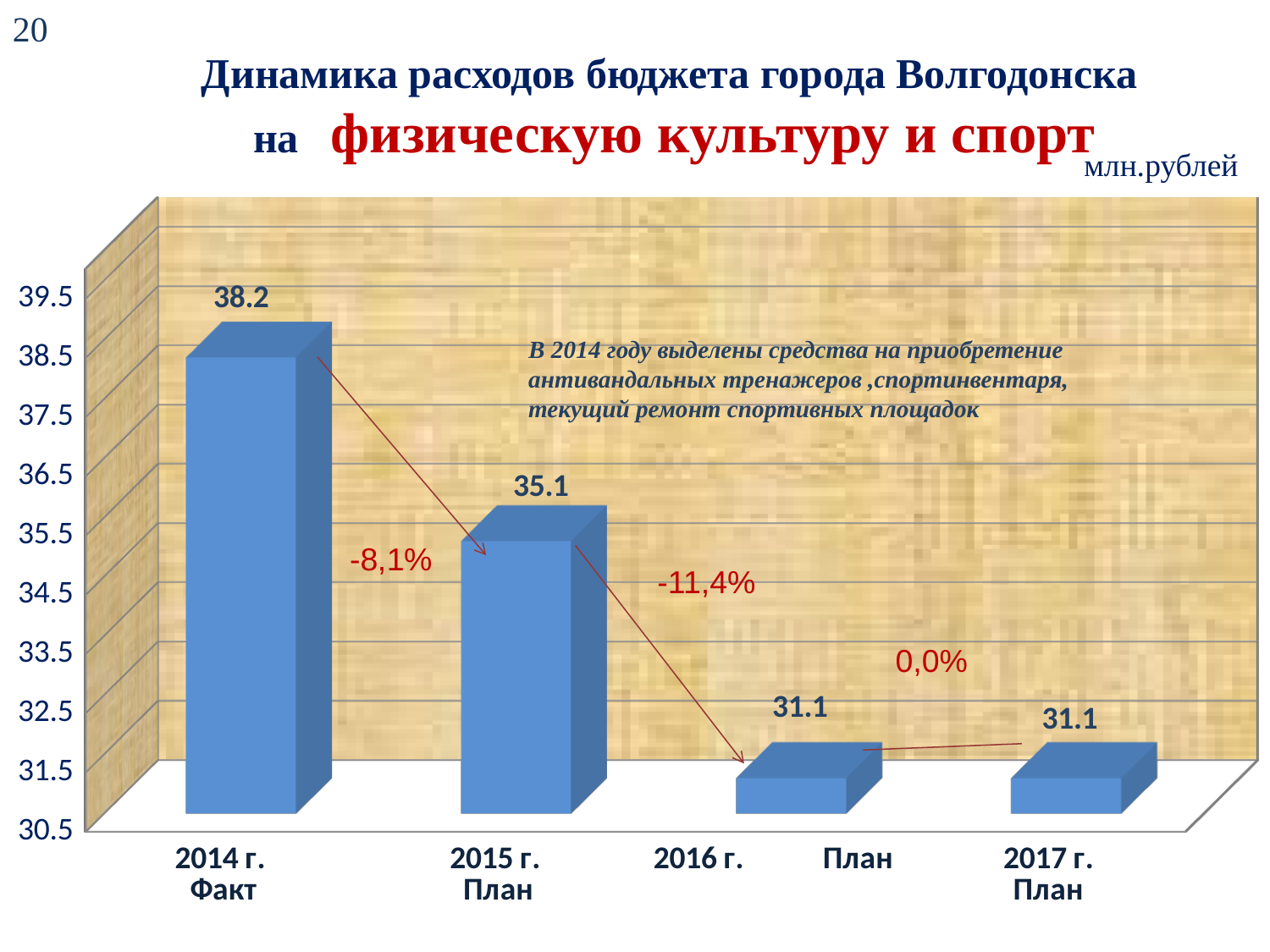
What is the difference between the values for 2015 г. План and 2016 г. План? 4.0 Do the values rise or fall from 2014 г. Факт to 2016 г. План? Fall What is the value for 2014 г. Факт? 38.2 Which category has the highest value? 2014 г. Факт How many bars are plotted in the chart? 4 What unit of measurement is indicated for the chart? млн.рублей What kind of chart is shown on the slide? Bar chart What percentage change is shown between 2015 г. План and 2016 г. План? -11,4% What is the value for 2017 г. План? 31.1 What is the difference between the values for 2014 г. Факт and 2015 г. План? 3.1 Which is larger, the value for 2015 г. План or the value for 2017 г. План? 2015 г. План What is the value for 2015 г. План? 35.1